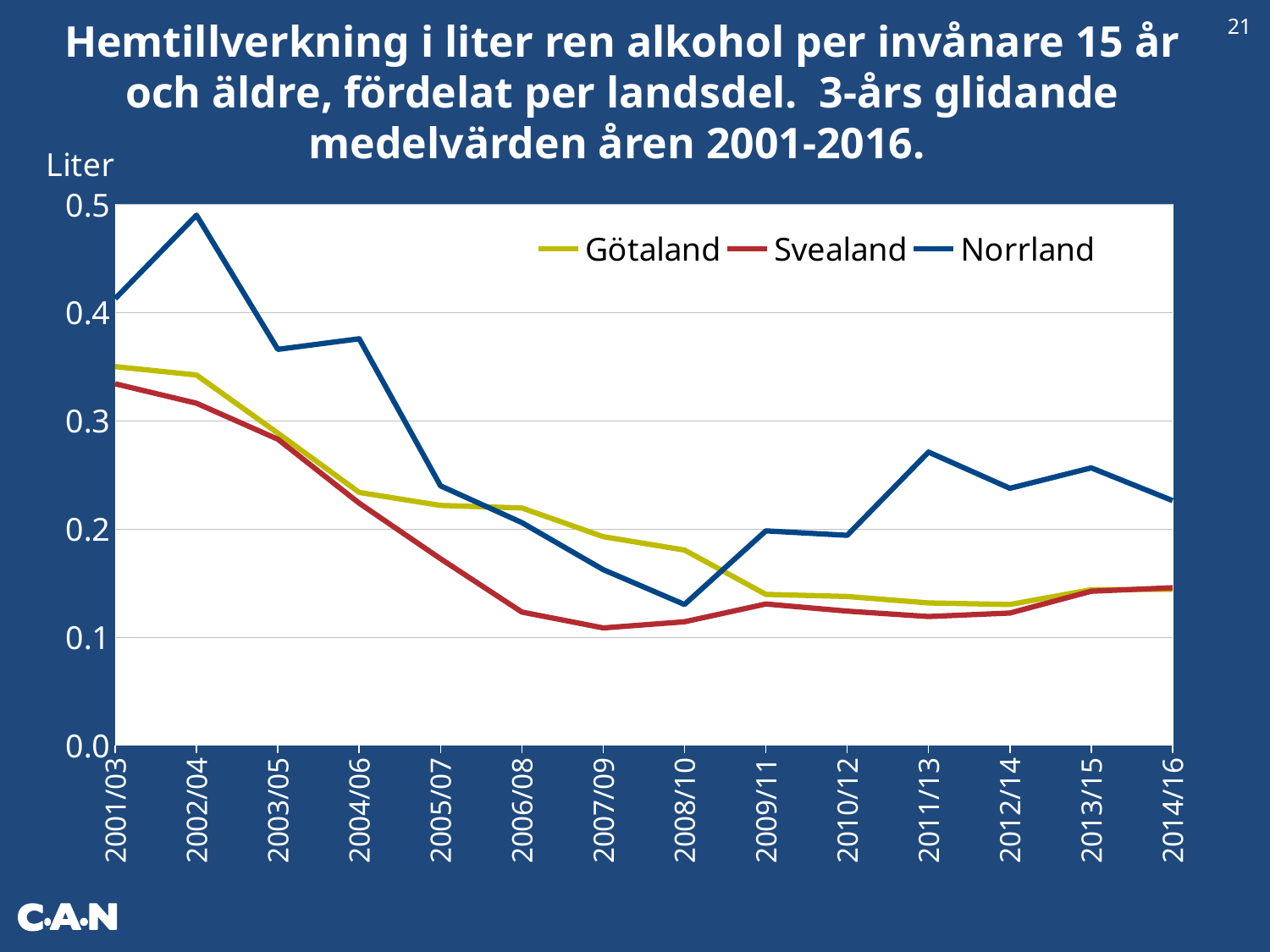
What kind of chart is shown on the slide? line chart Which series has the lowest value at 2007/09? Svealand Does the Götaland series rise or fall overall from 2001/03 to 2014/16? fall Which series has the highest value at 2002/04? Norrland Is the value for Götaland at 2001/03 greater or less than 0.4? less What unit is shown on the y axis label? Liter Which is larger at 2014/16, Norrland or Götaland? Norrland How many series does the legend list? 3 In which period does Norrland reach its highest value? 2002/04 Is the value for Norrland at 2008/10 greater or less than 0.2? less How many periods are shown along the x axis? 14 Is the value for Norrland at 2002/04 greater or less than 0.4? greater